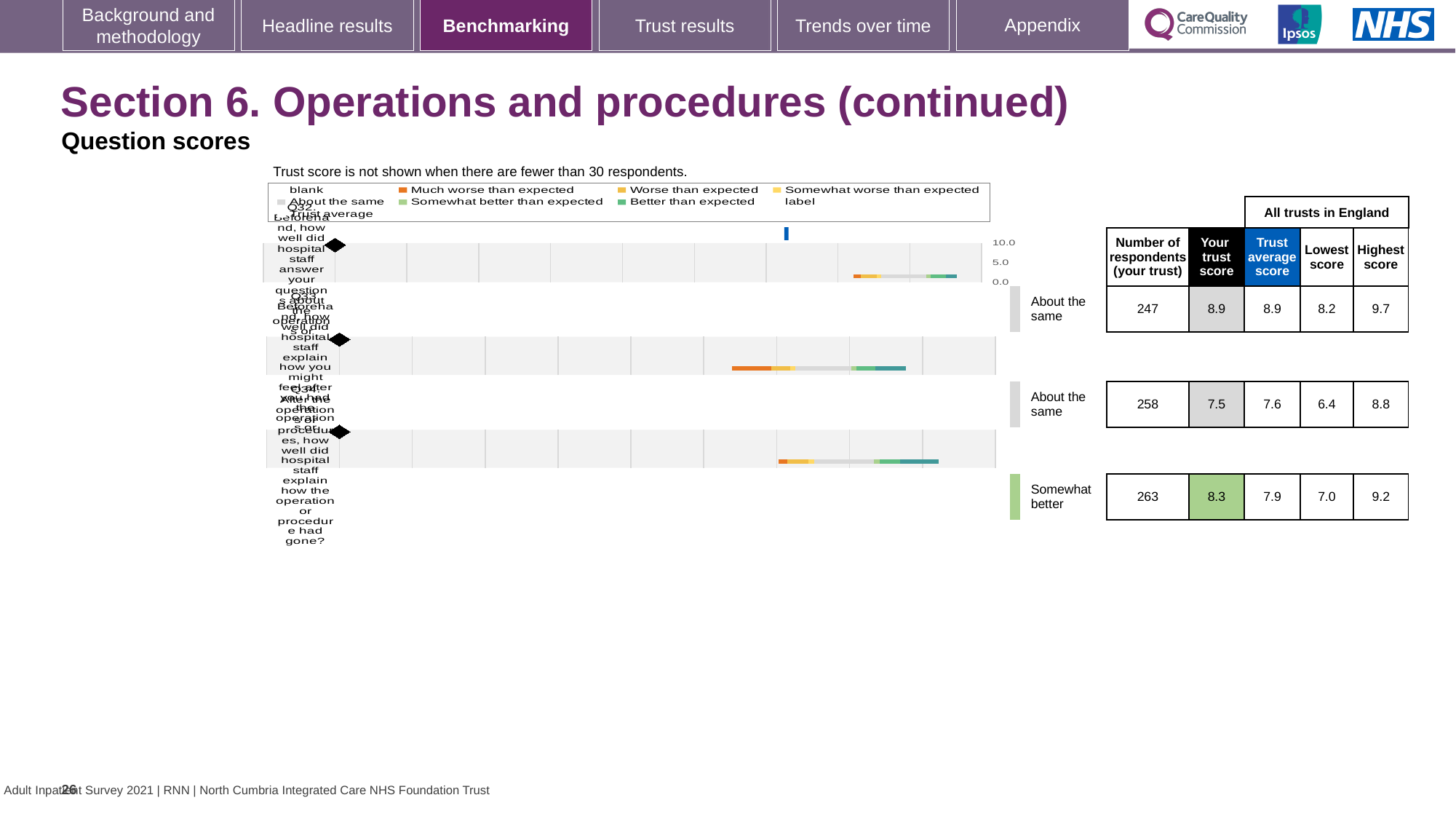
What is the number of respondents for the first question row in the table? 247 What is the trust score for the second question row in the table? 7.5 What is the trust average score for the third question row? 7.9 Which question row has the highest number of respondents? The third row (263) How many question rows are plotted in the benchmarking chart? 3 What is the maximum value shown on the chart's score axis? 10.0 What is the trust score for the third question row in the table? 8.3 What is the highest score across all trusts in England for the first question row? 9.7 What benchmark category is shown for the third question row? Somewhat better What is the difference between the trust score and the trust average score for the third question row? 0.4 What is the lowest score across all trusts in England for the second question row? 6.4 Is the trust score for the second question row larger or smaller than the trust average score for that row? Smaller